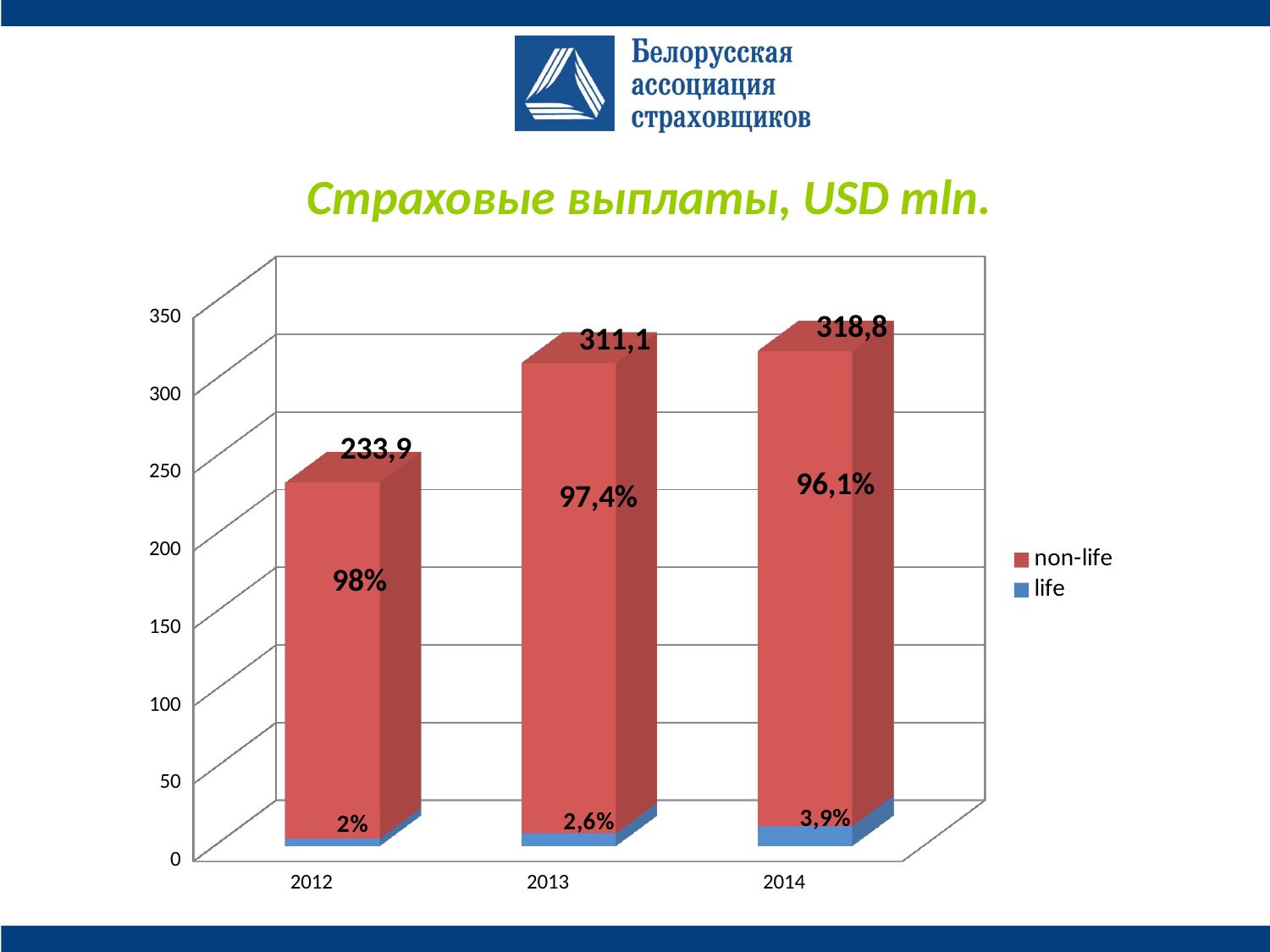
Which is larger, the total for 2013 or the total for 2012? 2013 Which year has the highest total value? 2014 What is the difference between the total values for 2014 and 2013? 7,7 What percentage is labelled for non-life in 2013? 97,4% Which year has the lowest total value? 2012 What is the total value labelled above the bar for 2012? 233,9 What is the total insurance payout value shown for 2013? 311,1 Do the total values rise or fall from 2012 to 2014? Rise How many series does the legend list? 2 What kind of chart is shown on the slide? Stacked bar chart How many years are shown on the x axis? 3 What share of the 2014 bar is labelled as life? 3,9%